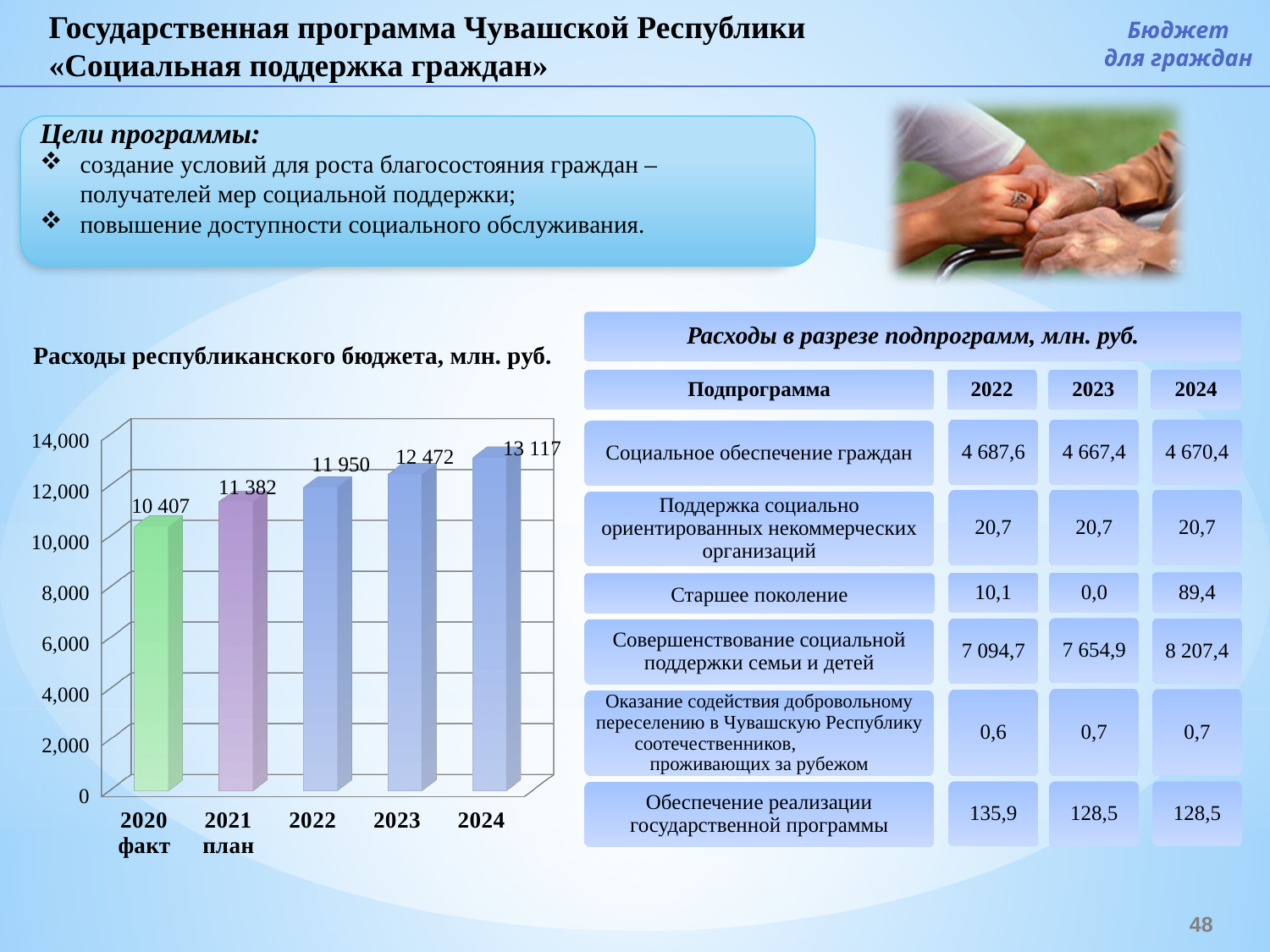
Do the values in the chart 'Расходы республиканского бюджета, млн. руб.' rise or fall from 2020 to 2024? rise How many bars are shown in the chart 'Расходы республиканского бюджета, млн. руб.'? 5 Is the value for 2021 план in the chart 'Расходы республиканского бюджета, млн. руб.' greater or less than 12,000? less What is the value for 2022 in the chart 'Расходы республиканского бюджета, млн. руб.'? 11 950 Which year has the highest value in the chart 'Расходы республиканского бюджета, млн. руб.'? 2024 What is the difference between the 2024 and 2020 values in the chart 'Расходы республиканского бюджета, млн. руб.'? 2 710 In the chart 'Расходы республиканского бюджета, млн. руб.', which is larger: the value for 2021 план or the value for 2022? 2022 What is the value for 2020 (факт) in the chart 'Расходы республиканского бюджета, млн. руб.'? 10 407 What is the difference between the 2023 and 2022 values in the chart 'Расходы республиканского бюджета, млн. руб.'? 522 What is the value for 2024 in the chart 'Расходы республиканского бюджета, млн. руб.'? 13 117 Which year has the lowest value in the chart 'Расходы республиканского бюджета, млн. руб.'? 2020 факт What type of chart is 'Расходы республиканского бюджета, млн. руб.'? bar chart